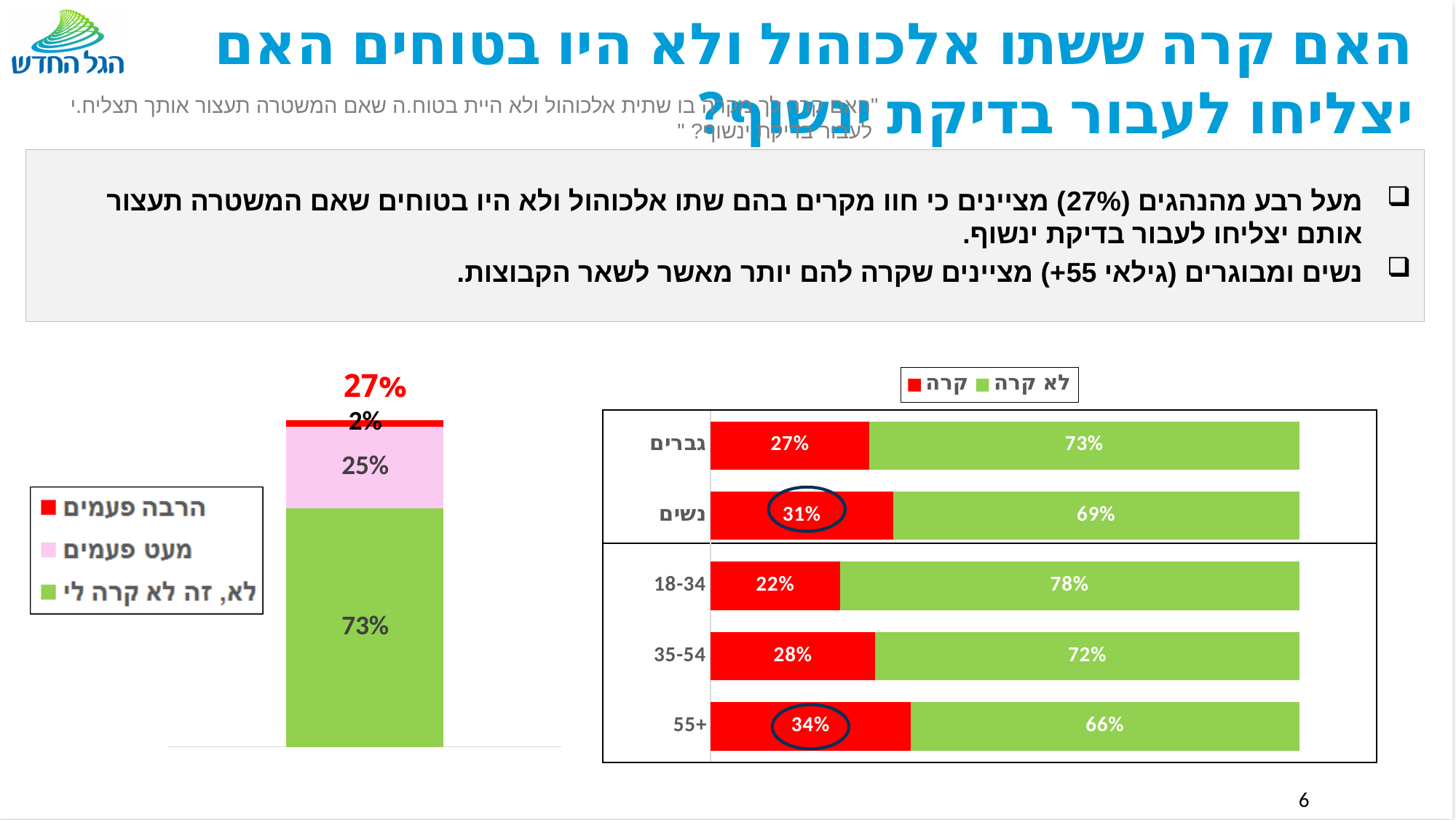
In the left-hand chart, what is the value for מעט פעמים? 25% In the left-hand chart, which colour represents לא, זה לא קרה לי? Green In the right-hand chart, which category has the highest value for קרה? 55+ How many series does the legend of the right-hand chart list? 2 What kind of chart is the right-hand chart? Stacked bar chart How many categories are shown in the right-hand chart? 5 In the right-hand chart, what is the difference between the קרה values for 55+ and 18-34? 12% In the right-hand chart, what is the value of לא קרה for 18-34? 78% In the right-hand chart, which category has the lowest value for קרה? 18-34 In the right-hand chart, what is the value of קרה for נשים? 31% In the left-hand chart, what is the combined value of הרבה פעמים and מעט פעמים? 27% In the right-hand chart, which has a larger קרה value, גברים or נשים? נשים